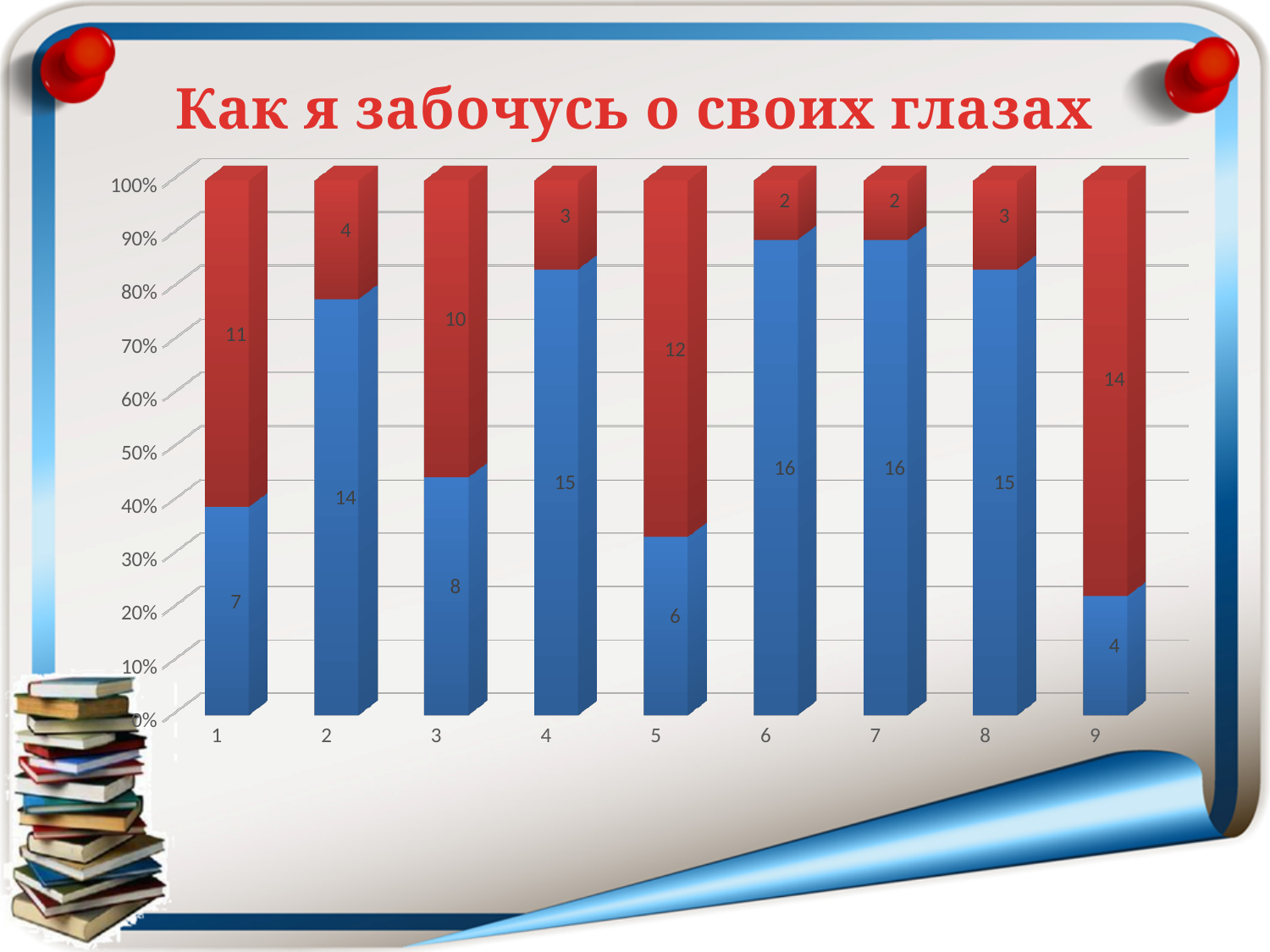
What is the total of the stacked bar for category 1? 18 Which category has the highest red segment value? 9 What is the value of the blue segment for category 4? 15 What is the value of the red segment for category 5? 12 What is the value of the red segment for category 9? 14 How many categories are shown on the x axis? 9 What kind of chart is shown on the slide? Stacked bar chart What is the value of the blue segment for category 1? 7 What is the title of the chart? Как я забочусь о своих глазах What is the difference between the blue and red segment values for category 3? 2 Is the blue segment value for category 6 larger than the blue segment value for category 2? Yes, 16 is larger than 14 Which category has the lowest blue segment value? 9